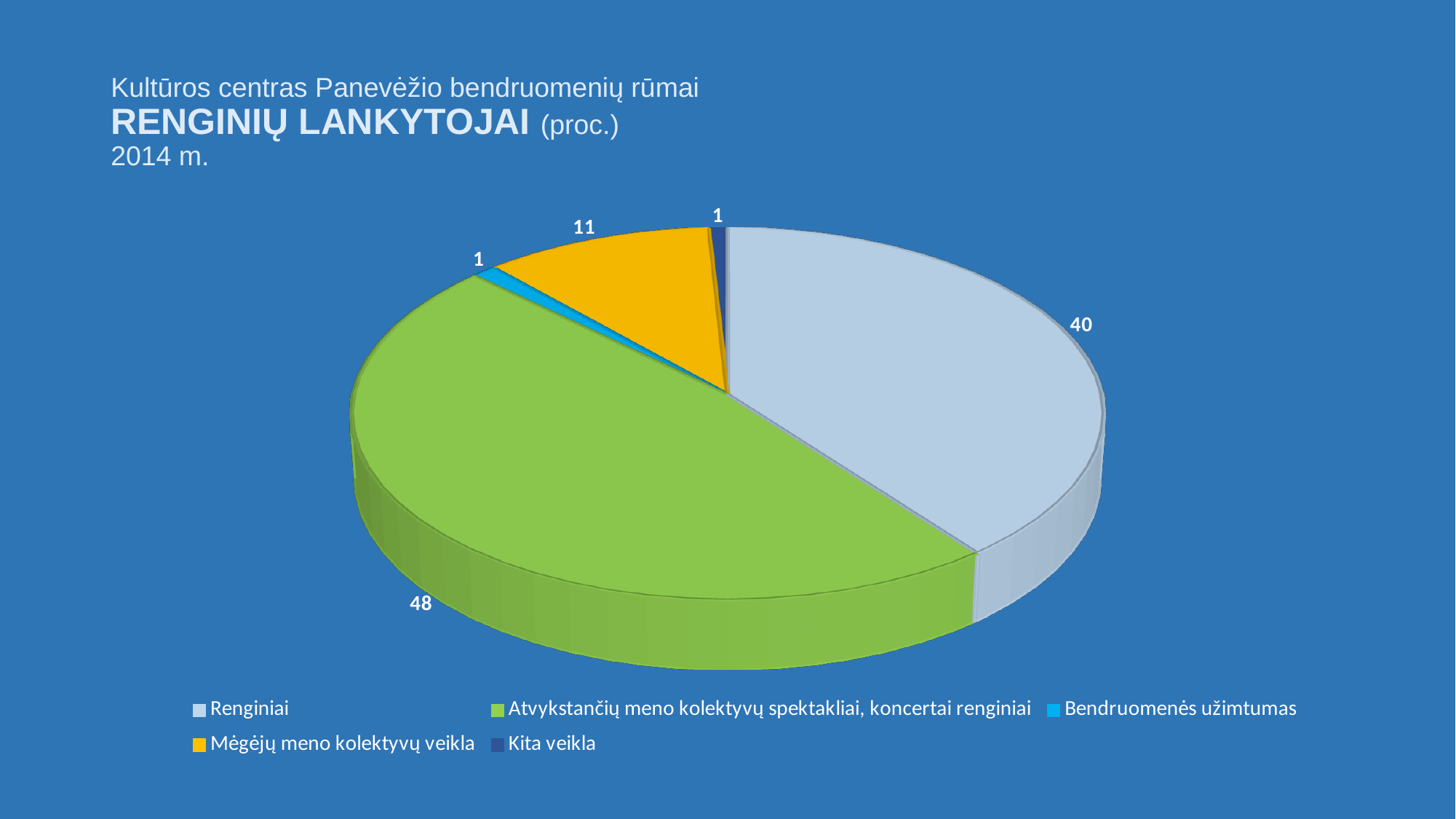
How many categories does the pie chart have? 5 Which is larger, the value for Renginiai or the value for Mėgėjų meno kolektyvų veikla? Renginiai What is the value for Mėgėjų meno kolektyvų veikla? 11 What is the difference between the values for Renginiai and Mėgėjų meno kolektyvų veikla? 29 Which year does the chart title refer to? 2014 m. What is the difference between the values for Atvykstančių meno kolektyvų spektakliai, koncertai renginiai and Renginiai? 8 What type of chart is shown on the slide? pie chart What is the value for Kita veikla? 1 What is the value for Atvykstančių meno kolektyvų spektakliai, koncertai renginiai? 48 What is the value for Bendruomenės užimtumas? 1 What is the value for Renginiai? 40 Which category has the largest slice? Atvykstančių meno kolektyvų spektakliai, koncertai renginiai